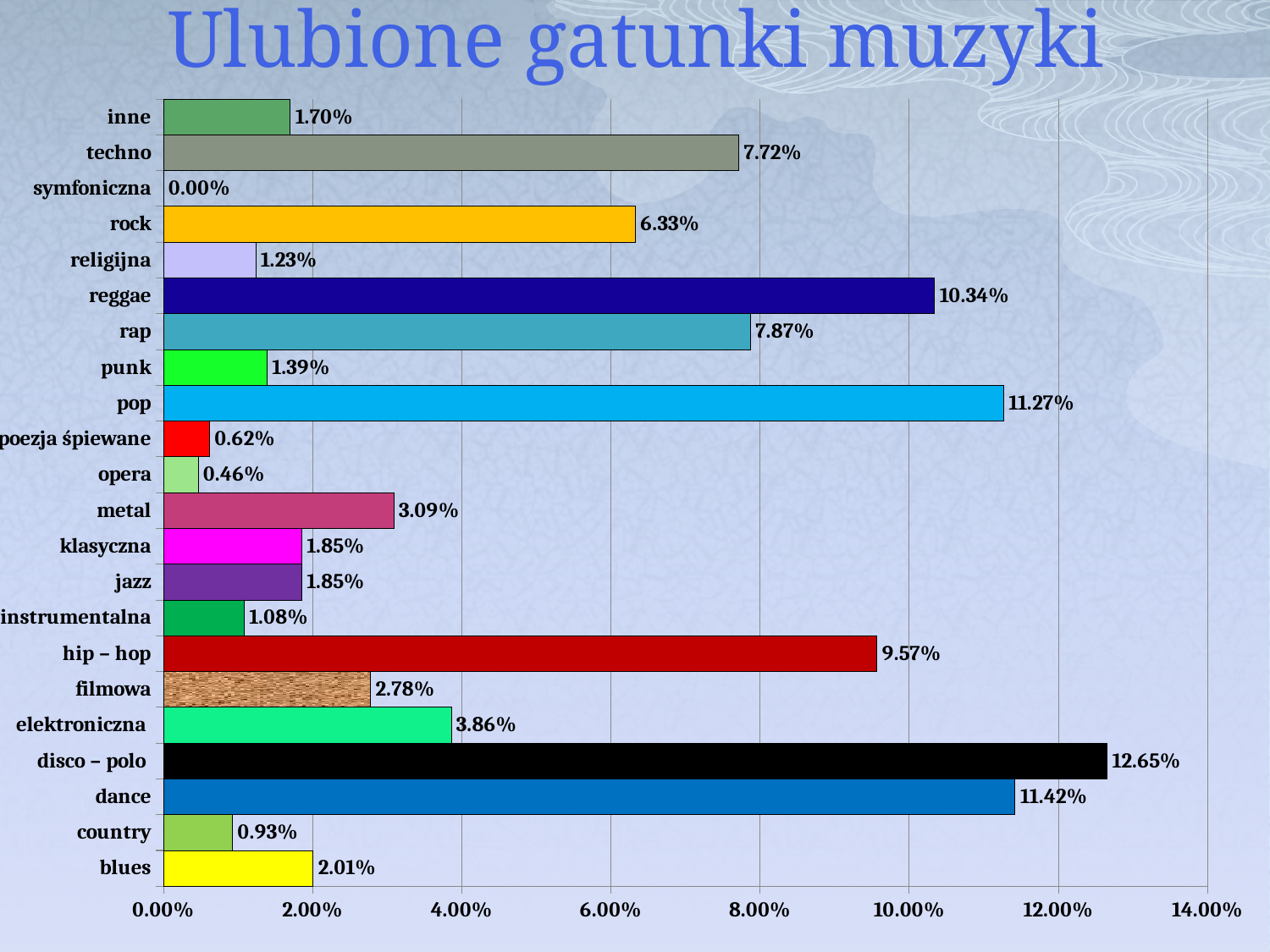
What is the value for reggae? 10.34% What is the difference between the values for disco – polo and dance? 1.23% Which category has the lowest value? symfoniczna Which category has the highest value? disco – polo What is the title of the chart? Ulubione gatunki muzyki Which is larger, the value for techno or the value for rap? rap What is the difference between the values for pop and reggae? 0.93% What is the value for hip – hop? 9.57% How many categories are shown in the chart? 22 What kind of chart is shown on the slide? bar chart Which is larger, the value for metal or the value for elektroniczna? elektroniczna What is the value for opera? 0.46%